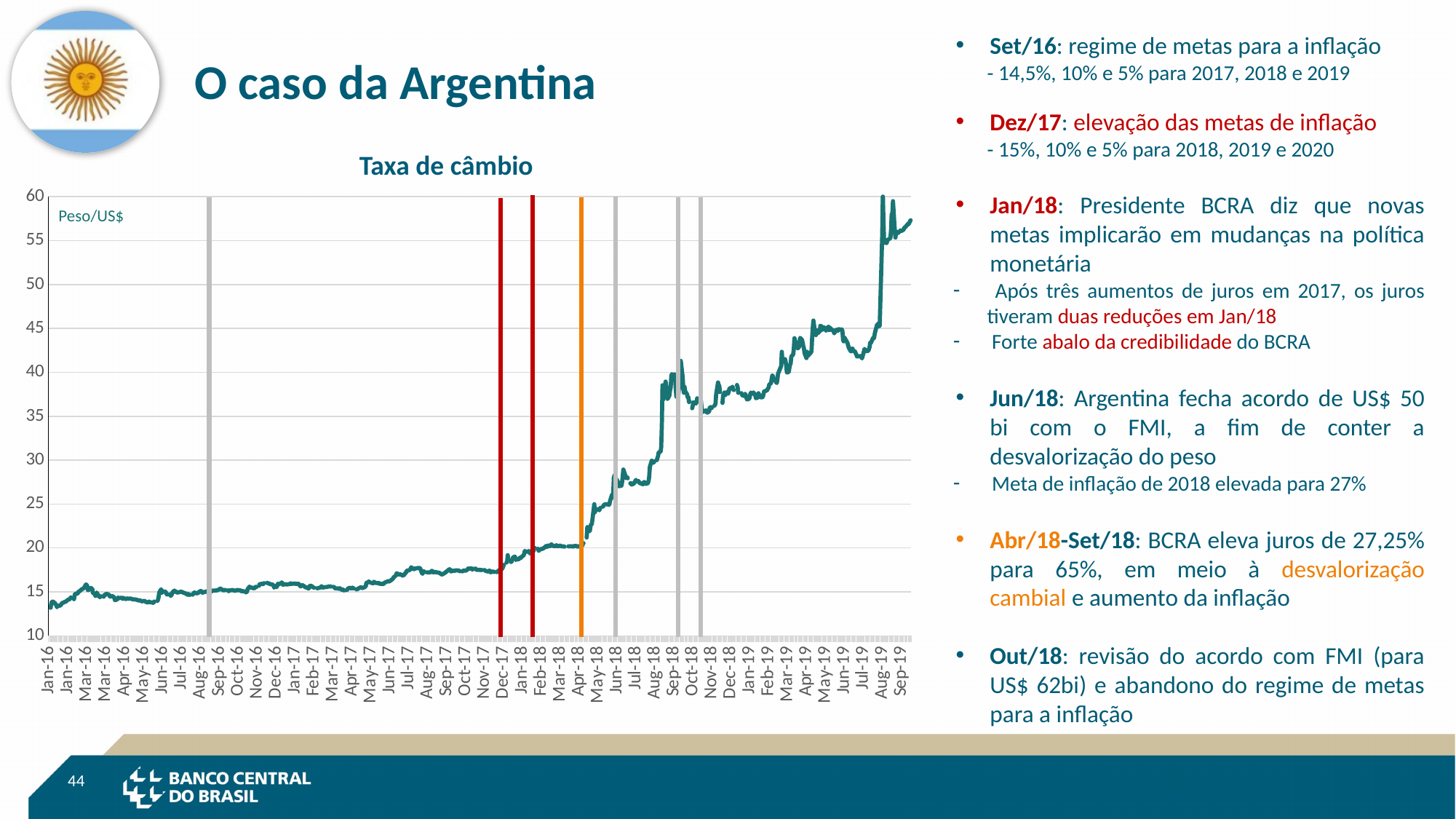
Is the value for Jan-16 greater or less than 15? less Is the value for Sep-19 greater or less than 50? greater What unit label is shown in the top-left corner of the chart's plot area? Peso/US$ What is the highest value shown on the chart's y axis? 60 Which is larger, the value for Jun-18 or the value for Jun-17? Jun-18 Is the value for Apr-18 greater or less than 25? less What kind of chart is shown under the title 'Taxa de câmbio'? line chart Which is larger, the value for Sep-19 or the value for Jan-16? Sep-19 What is the title of the chart on the slide? Taxa de câmbio Does the exchange rate line generally rise or fall from Jan-16 to Sep-19? rise